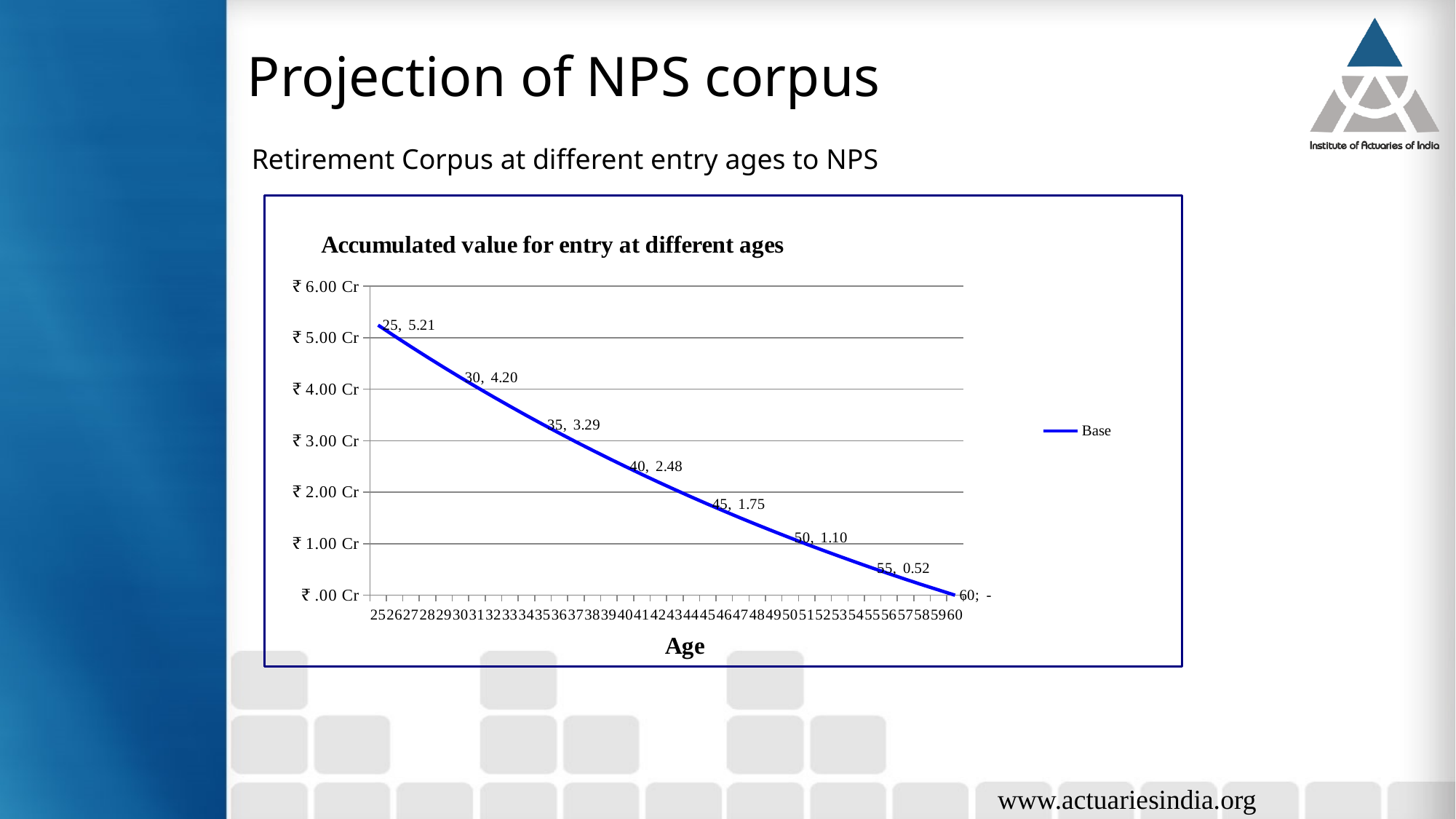
What is the title of the chart? Accumulated value for entry at different ages What is the accumulated value for entry at age 40? 2.48 How many series does the legend list? 1 Which has a larger accumulated value: entry at age 45 or entry at age 50? age 45 What is the accumulated value for entry at age 25? 5.21 Does the accumulated value rise or fall as entry age increases along the x axis? fall At which entry age is the accumulated value highest? 25 What type of chart is shown on the slide? line chart How many data points are labelled on the line? 8 At which entry age is the accumulated value lowest? 60 What is the accumulated value for entry at age 55? 0.52 What is the difference between the accumulated values for entry at age 30 and age 35? 0.91